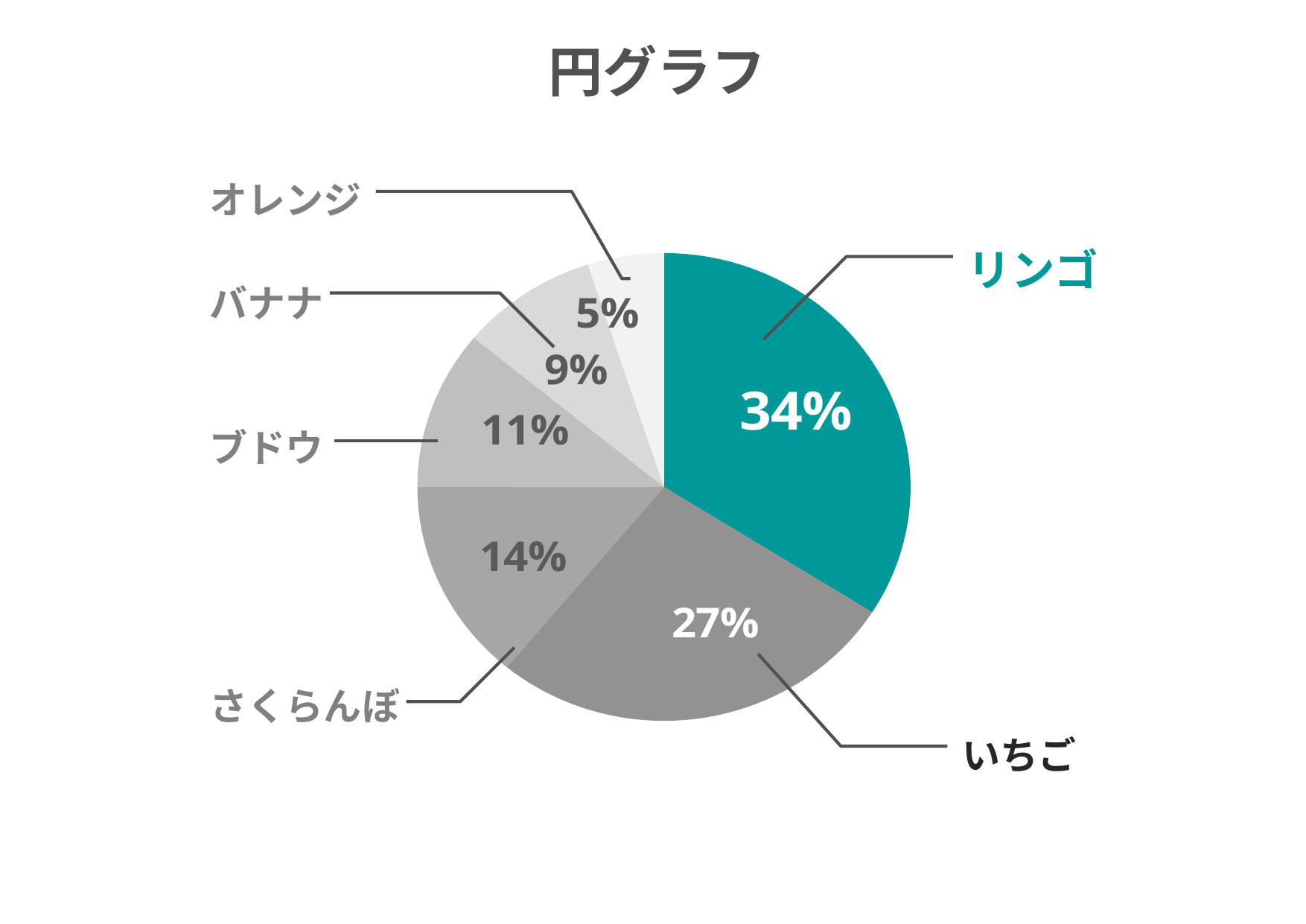
What is the title of the chart? 円グラフ What kind of chart is shown on the slide? pie chart What percentage does the いちご slice represent? 27% Which category has the smallest share of the pie? オレンジ What percentage does the オレンジ slice represent? 5% What percentage does the ブドウ slice represent? 11% How many slices does the pie chart have? 6 What percentage does the リンゴ slice represent? 34% Which category has the largest share of the pie? リンゴ What is the difference in percentage points between リンゴ and いちご? 7 What percentage does the さくらんぼ slice represent? 14% What percentage does the バナナ slice represent? 9%